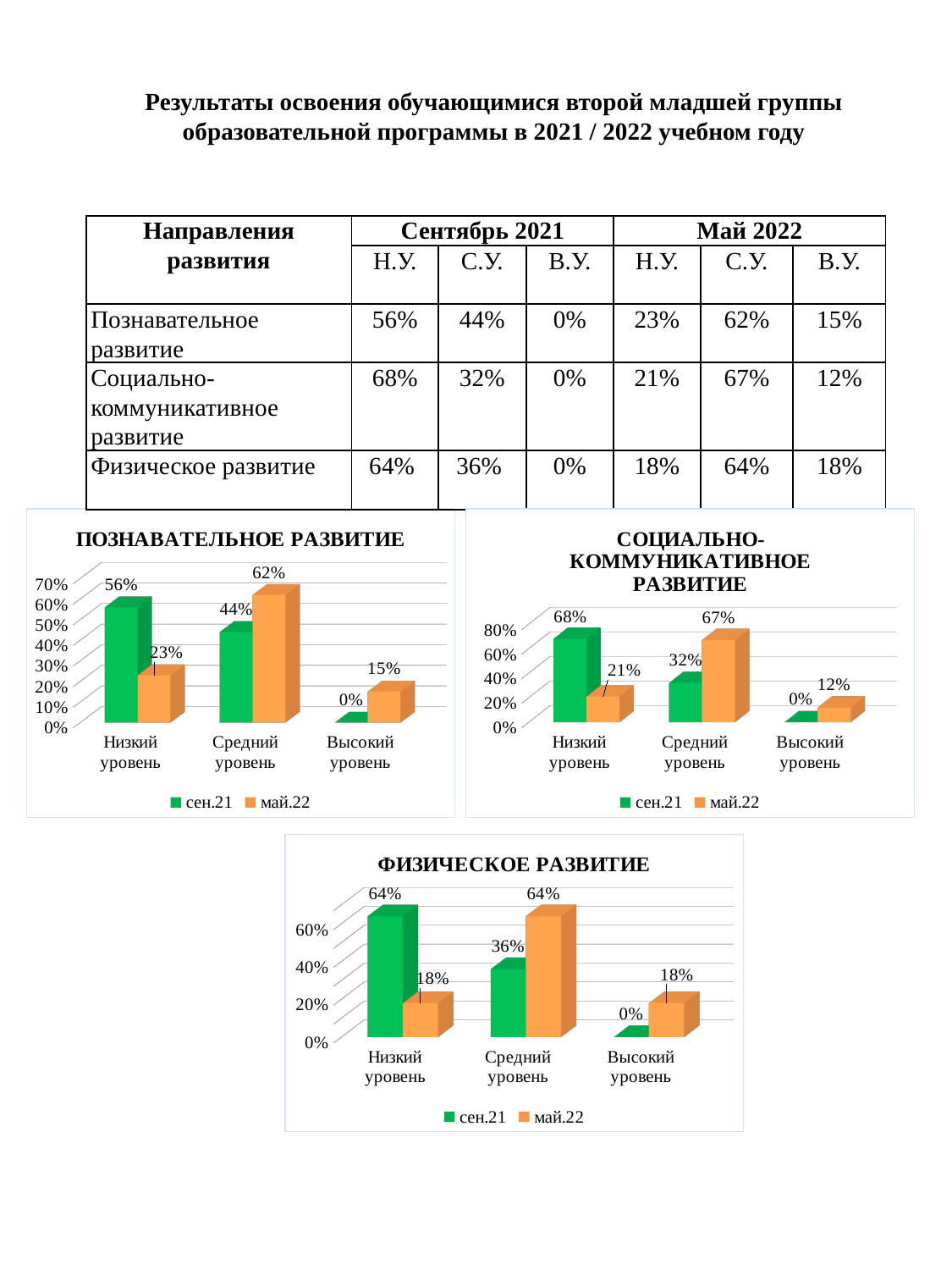
In the chart titled СОЦИАЛЬНО-КОММУНИКАТИВНОЕ РАЗВИТИЕ, what is the value for сен.21 at Низкий уровень? 68% In the chart titled СОЦИАЛЬНО-КОММУНИКАТИВНОЕ РАЗВИТИЕ, which category has the lowest сен.21 value? Высокий уровень In the chart titled ПОЗНАВАТЕЛЬНОЕ РАЗВИТИЕ, what is the difference between the май.22 and сен.21 values at Средний уровень? 18% In the chart titled ПОЗНАВАТЕЛЬНОЕ РАЗВИТИЕ, which category has the highest май.22 value? Средний уровень What kind of chart is the chart titled ФИЗИЧЕСКОЕ РАЗВИТИЕ? Bar chart In the chart titled ПОЗНАВАТЕЛЬНОЕ РАЗВИТИЕ, what is the value for май.22 at Высокий уровень? 15% In the chart titled ФИЗИЧЕСКОЕ РАЗВИТИЕ, what is the difference between the сен.21 and май.22 values at Низкий уровень? 46% In the chart titled СОЦИАЛЬНО-КОММУНИКАТИВНОЕ РАЗВИТИЕ, what is the value for май.22 at Средний уровень? 67% In the chart titled СОЦИАЛЬНО-КОММУНИКАТИВНОЕ РАЗВИТИЕ, which is larger at Низкий уровень: сен.21 or май.22? сен.21 In the chart titled ПОЗНАВАТЕЛЬНОЕ РАЗВИТИЕ, what is the value for сен.21 at Низкий уровень? 56% How many series does the legend list in the chart titled ФИЗИЧЕСКОЕ РАЗВИТИЕ? 2 In the chart titled ФИЗИЧЕСКОЕ РАЗВИТИЕ, what is the value for май.22 at Низкий уровень? 18%